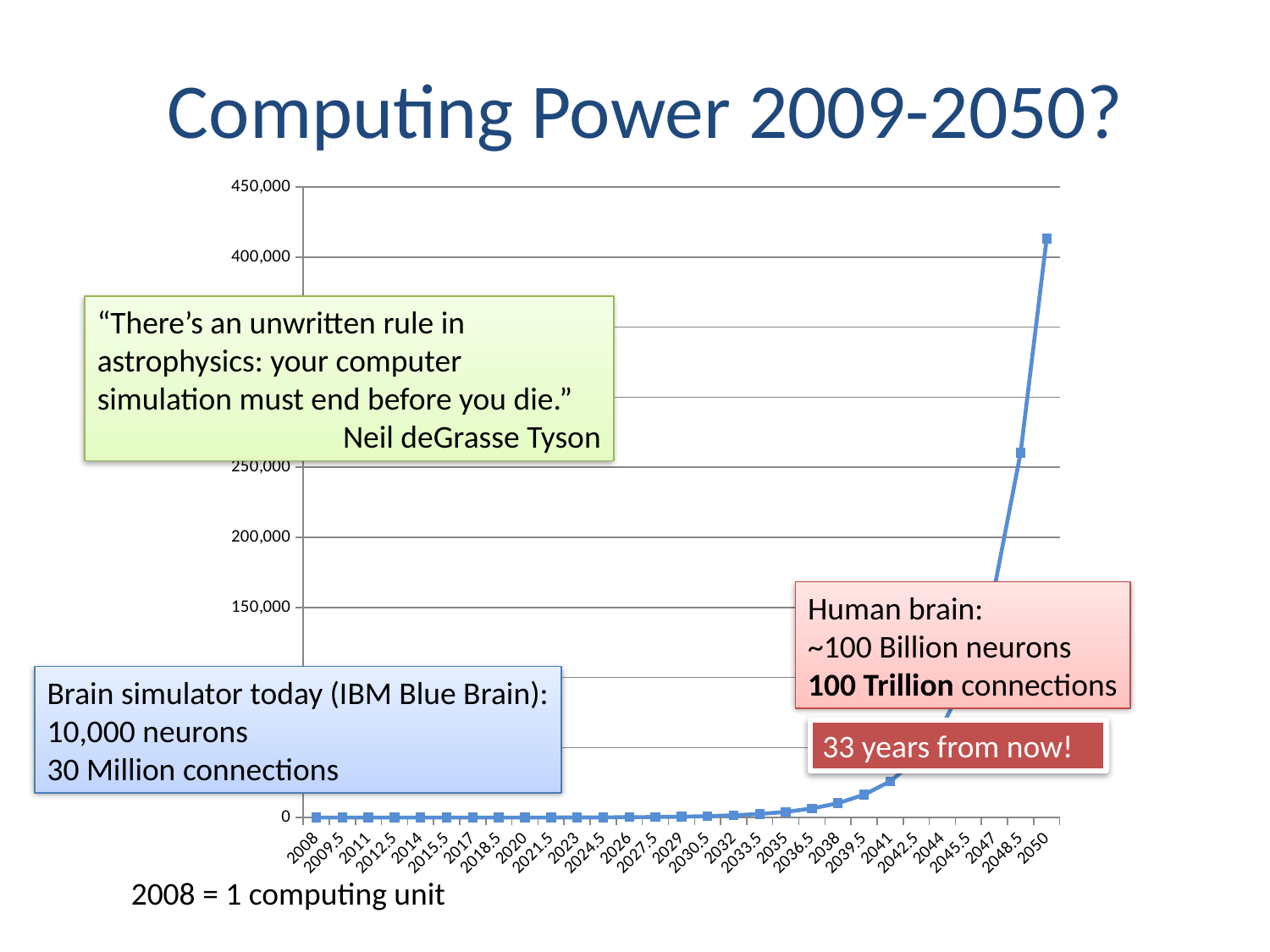
What is the highest value shown on the y axis? 450,000 Do the plotted values rise or fall as the years increase along the x axis? rise Is the value for 2048.5 greater or less than 300,000? less What is the first year label on the x axis? 2008 What kind of chart is shown on the slide? line chart How many year labels are shown along the x axis? 29 Is the value for 2050 greater or less than 400,000? greater Is the value for 2048.5 greater or less than 250,000? greater Which year has the highest plotted value? 2050 Which is larger, the value for 2050 or the value for 2048.5? 2050 What is the title of the chart on the slide? Computing Power 2009-2050?